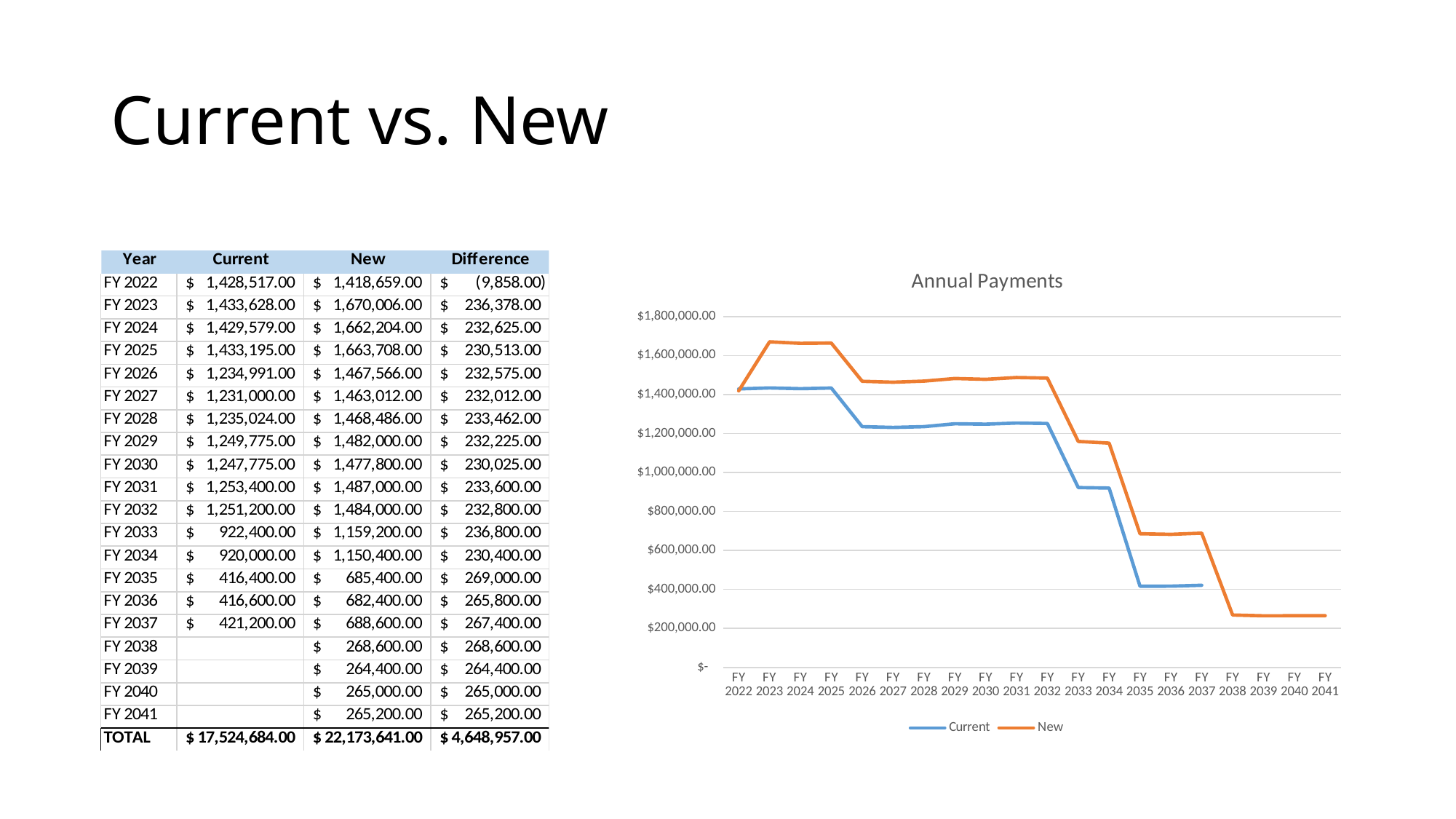
In FY 2030, which series has the larger value, Current or New? New Is the value of the New series for FY 2038 greater or less than $200,000.00? greater What kind of chart is shown on the slide? line chart According to the table, what is the Current payment for FY 2022? $ 1,428,517.00 How many series does the chart's legend list? 2 What is the title of the chart? Annual Payments Does the Current series rise or fall overall from FY 2022 to FY 2037? fall According to the table, what is the difference between the New and Current payments for FY 2035? $ 269,000.00 Which colour is used for the New series in the chart? orange How many fiscal years are shown along the x axis of the chart? 20 Is the value of the New series for FY 2023 greater or less than $1,600,000.00? greater Is the value of the Current series for FY 2033 greater or less than $1,000,000.00? less